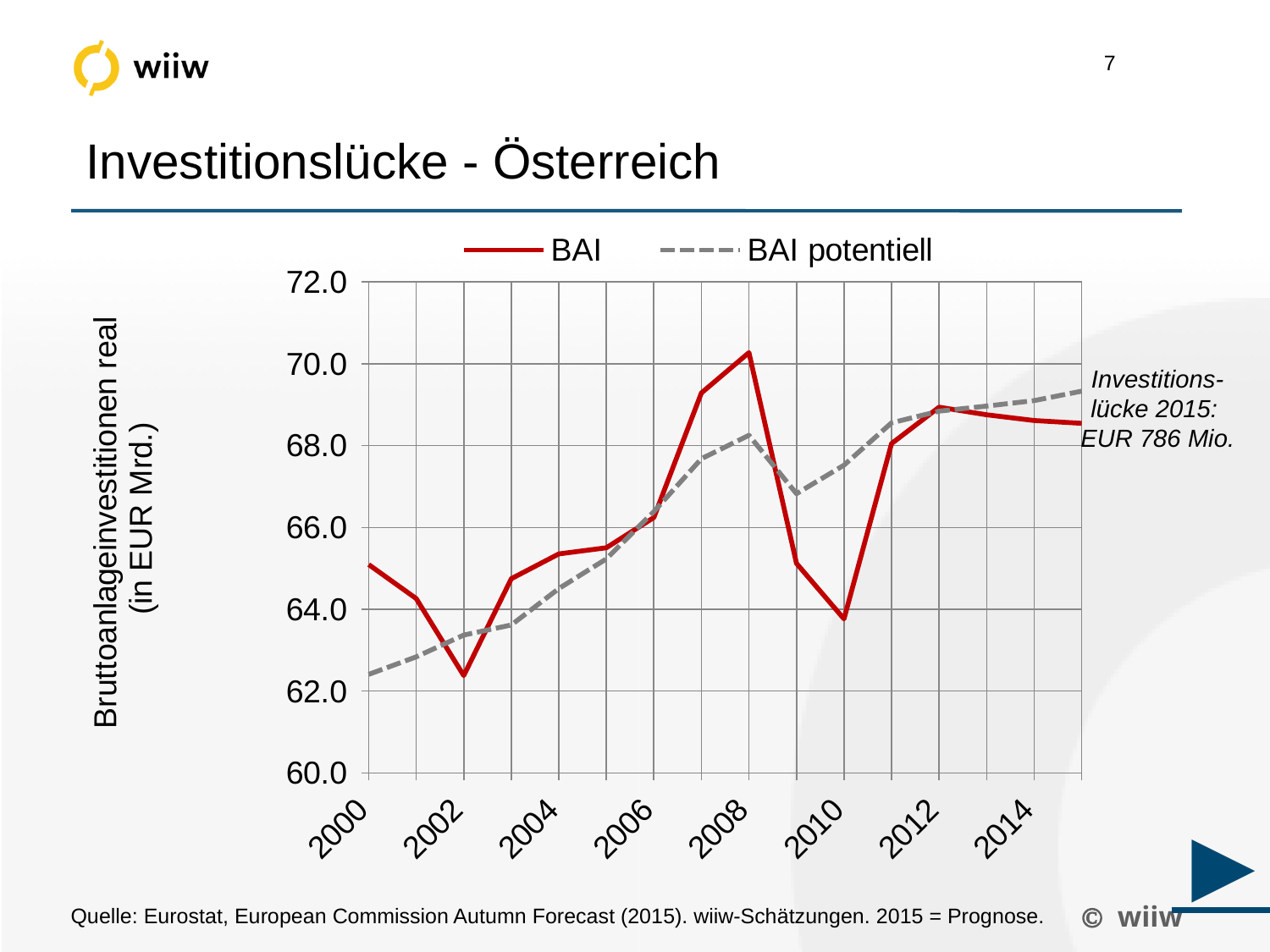
Is the value for BAI potentiell in 2015 greater or less than 68.0? greater What kind of chart is shown on the slide? line chart In which year does the BAI series reach its highest value? 2008 In which year does the BAI series reach its lowest value? 2002 Is the value for BAI in 2009 greater or less than 66.0? less In 2008, which series has the larger value, BAI or BAI potentiell? BAI What are the two series named in the legend? BAI and BAI potentiell How many series does the legend list? 2 Is the value for BAI in 2002 greater or less than 64.0? less In 2010, which series has the larger value, BAI or BAI potentiell? BAI potentiell What is the title of the slide containing the chart? Investitionslücke - Österreich Does the BAI series rise or fall between 2008 and 2010? fall